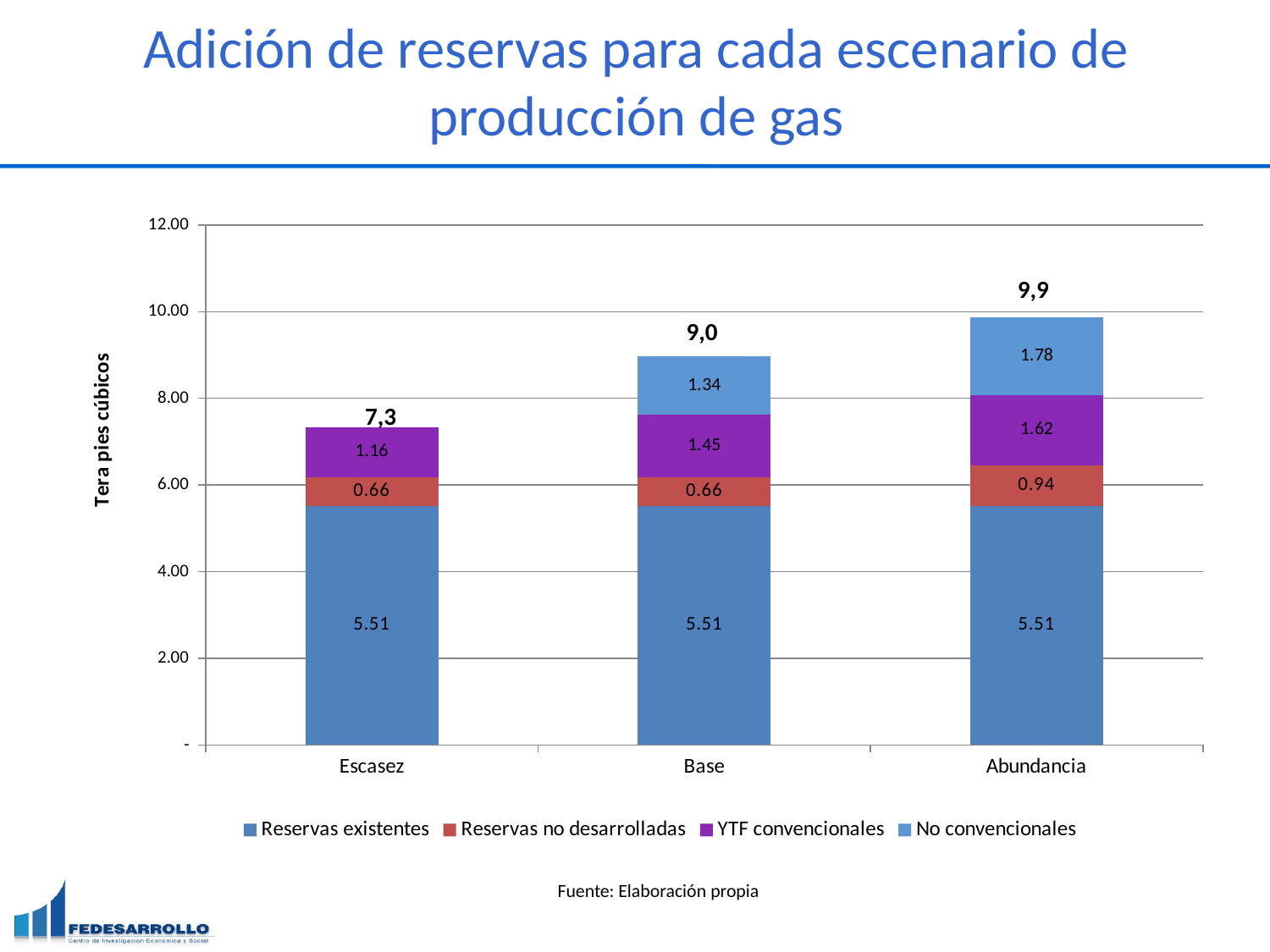
What type of chart is shown on the slide? Stacked bar chart What is the value of Reservas no desarrolladas for the Escasez scenario? 0.66 How many scenarios (categories) are shown on the x axis? 3 What is the total labelled above the Abundancia bar? 9,9 What is the difference between the YTF convencionales values for Abundancia and Escasez? 0.46 What is the value of YTF convencionales for the Base scenario? 1.45 What is the label of the y axis? Tera pies cúbicos Is the No convencionales value larger for Base or for Abundancia? Abundancia Which scenario has the highest total reserves? Abundancia Which scenario has the lowest total reserves? Escasez How many series does the legend list? 4 What is the value of No convencionales for the Abundancia scenario? 1.78